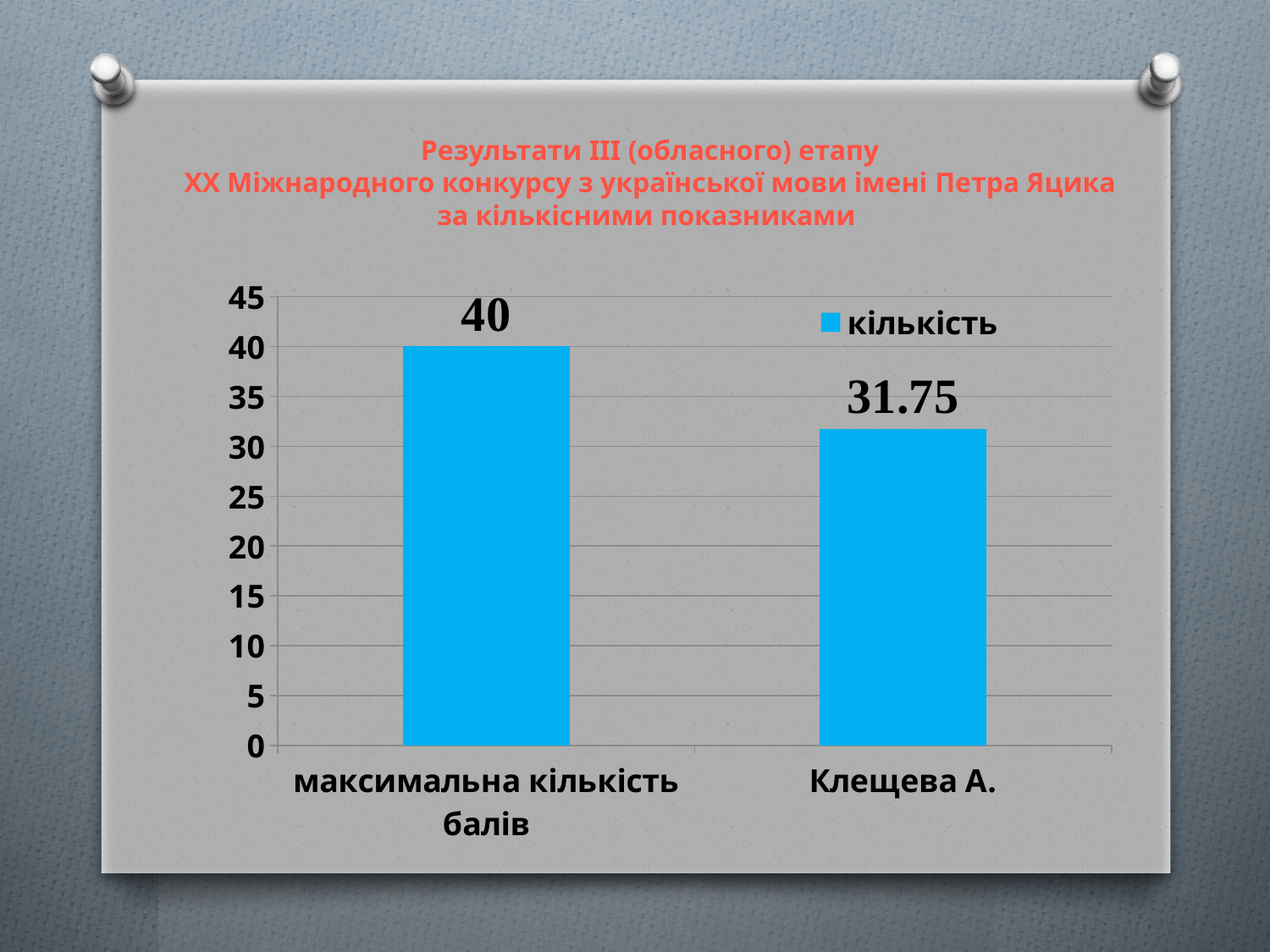
How many series does the legend list? 1 What is the difference between the value for "максимальна кількість балів" and the value for "Клещева А."? 8.25 What is the name of the series shown in the legend? кількість Is the value for "Клещева А." greater or less than 35? less What kind of chart is shown on the slide? bar chart What is the maximum value shown on the vertical axis? 45 What is the value for "максимальна кількість балів"? 40 Which category has the lowest value? Клещева А. How many categories are shown on the x axis? 2 Which category has the highest value? максимальна кількість балів What is the value for "Клещева А."? 31.75 Which is larger: the value for "Клещева А." or the value for "максимальна кількість балів"? максимальна кількість балів